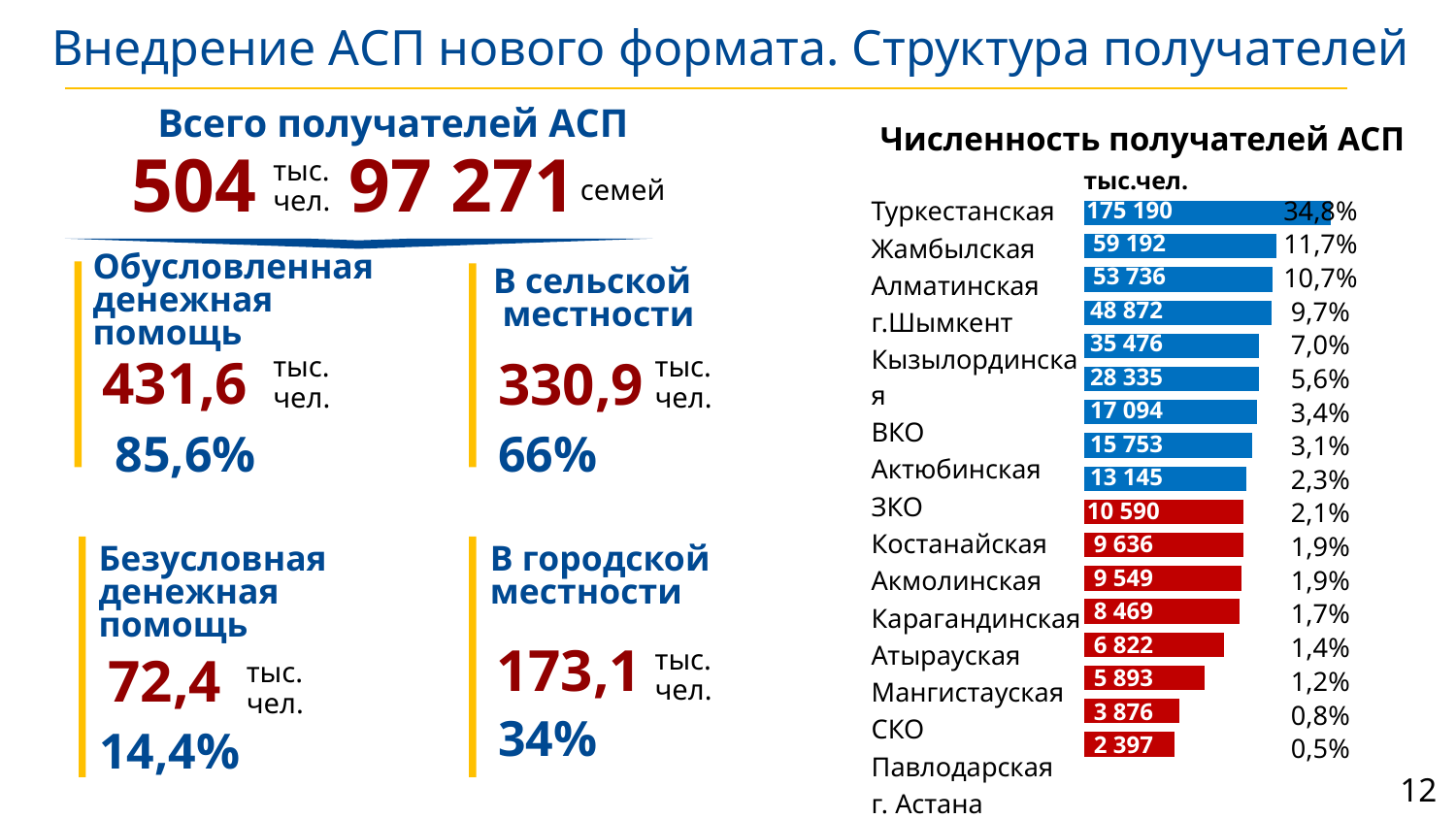
How many bars are plotted in the chart "Численность получателей АСП"? 17 In the chart "Численность получателей АСП", what percentage is shown for Туркестанская? 34,8% In the chart "Численность получателей АСП", what is the smallest value shown on a bar? 2 397 In the chart "Численность получателей АСП", what is the difference between the values for Алматинская and г.Шымкент? 4 864 In the chart "Численность получателей АСП", do the bar values increase or decrease from top to bottom? decrease In the chart "Численность получателей АСП", which is larger, the value for Алматинская or for г.Шымкент? Алматинская What kind of chart is "Численность получателей АСП"? bar chart In the chart "Численность получателей АСП", what percentage is shown for Жамбылская? 11,7% In the chart "Численность получателей АСП", which region has the highest value? Туркестанская In the chart "Численность получателей АСП", what is the value for Туркестанская? 175 190 In the chart "Численность получателей АСП", what is the value for Жамбылская? 59 192 In the chart "Численность получателей АСП", what is the difference between the values for Туркестанская and Жамбылская? 115 998